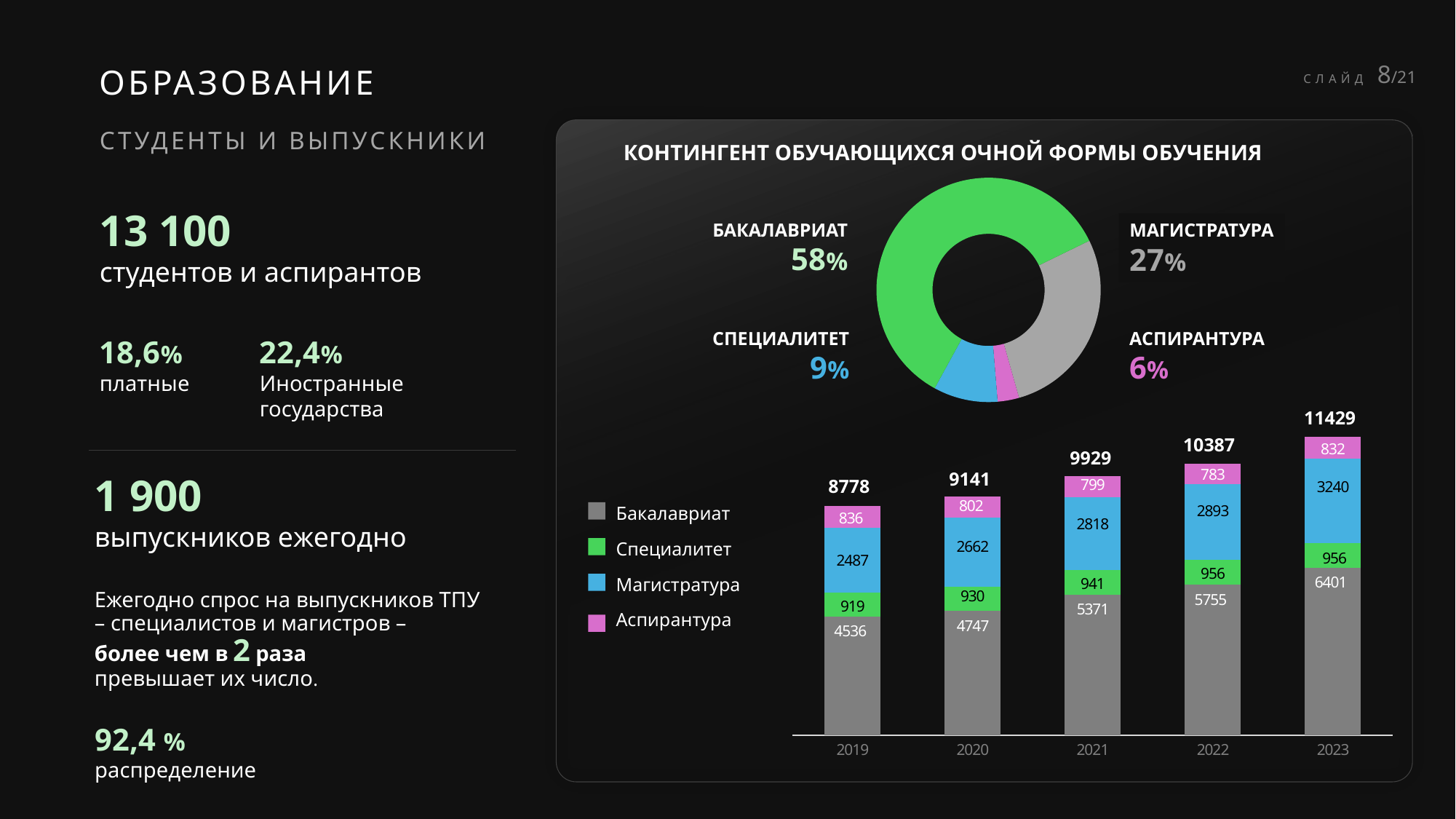
In the donut chart, what share is shown for Бакалавриат? 58% In the stacked bar chart, what is the value for Бакалавриат in 2023? 6401 In the stacked bar chart, what is the total of the 2022 bar? 10387 In the donut chart, what share is shown for Аспирантура? 6% In the donut chart, which category has the largest share? Бакалавриат In the stacked bar chart, which year has the highest total? 2023 In the stacked bar chart, how many years are shown on the x axis? 5 In the stacked bar chart, what is the difference between the Бакалавриат values for 2020 and 2019? 211 In the stacked bar chart, what is the value for Магистратура in 2021? 2818 In the stacked bar chart, how many series does the legend list? 4 In the stacked bar chart, do the bar totals rise or fall from 2019 to 2023? rise In the donut chart, which category has the smallest share? Аспирантура